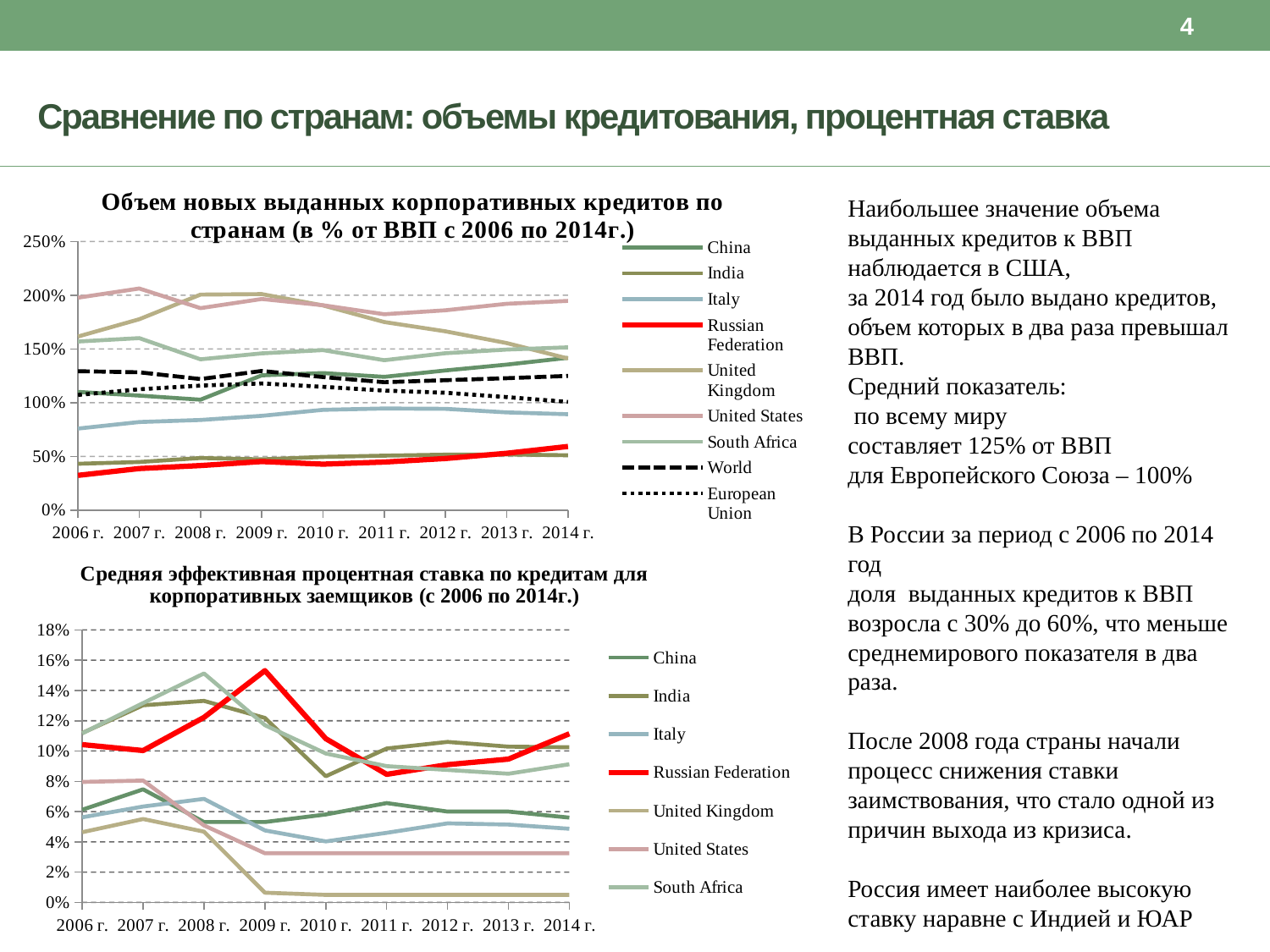
In the top chart, is the value for Russian Federation in 2006 г. greater or less than 50%? less In the bottom chart, which series has the lowest value in 2014 г.? United Kingdom In the bottom chart, which is larger in 2009 г.: Russian Federation or South Africa? Russian Federation How many series does the legend of the bottom chart, 'Средняя эффективная процентная ставка по кредитам для корпоративных заемщиков', list? 7 In the top chart, which series has the lowest value in 2006 г.? Russian Federation In the top chart, which series has the highest value in 2014 г.? United States In the top chart, is the value for United States in 2014 г. greater or less than 150%? greater What kind of chart is the top chart, 'Объем новых выданных корпоративных кредитов по странам'? Line chart In the bottom chart, is the value for United Kingdom in 2014 г. greater or less than 2%? less In the top chart, does the Russian Federation line rise or fall from 2006 г. to 2014 г.? rise How many series does the legend of the top chart list? 9 How many years are shown on the x axis of the top chart? 9